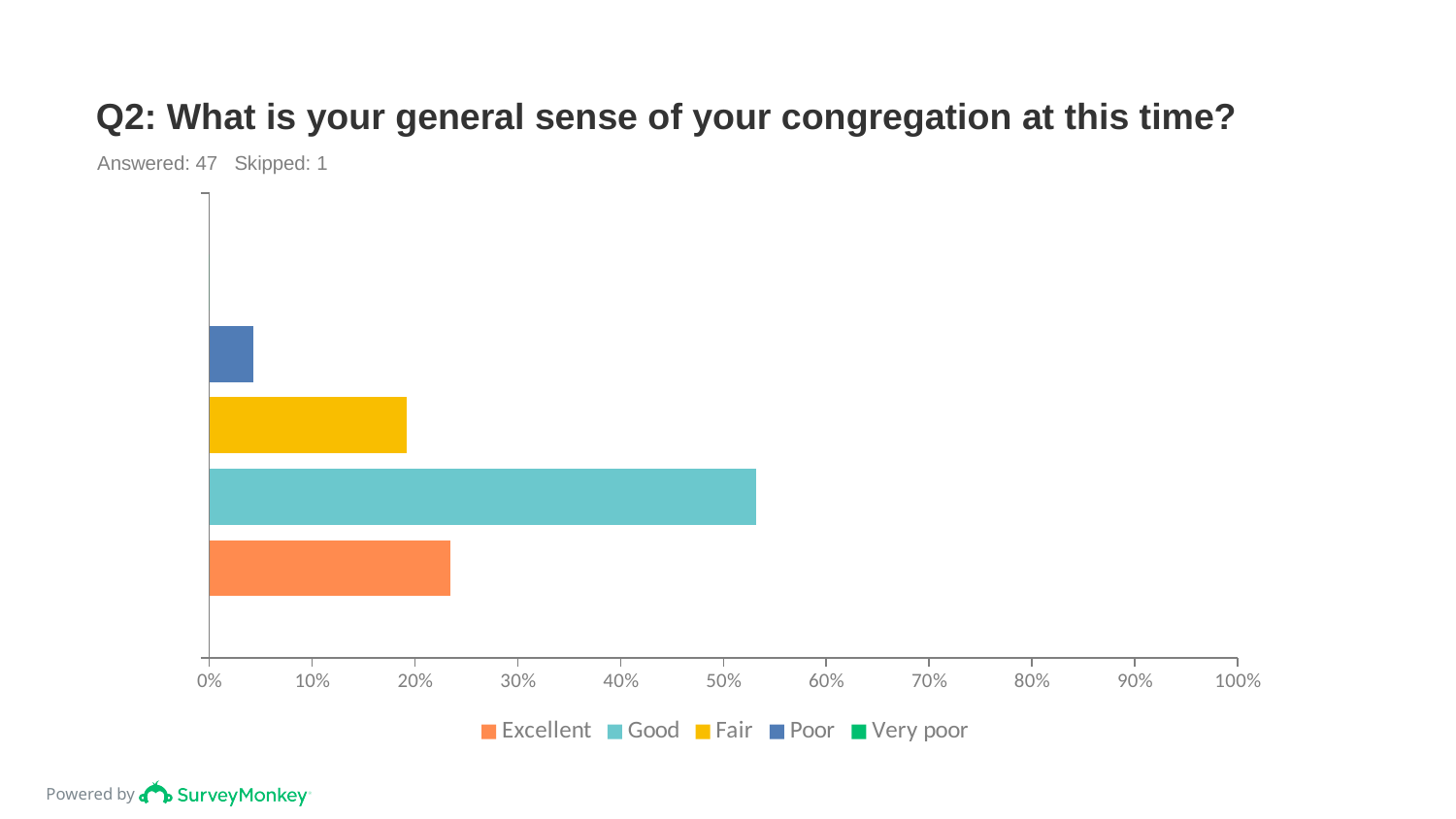
Which category has the highest value? Good How many respondents answered the question according to the slide? 47 What is the title of the chart? Q2: What is your general sense of your congregation at this time? Is the value for Poor greater or less than 10%? less Which category has the shortest visible bar? Poor Is the value for Good greater or less than 50%? greater Is the value for Excellent greater or less than 20%? greater How many entries does the legend list? 5 Which is larger, the value for Good or the value for Excellent? Good What kind of chart is shown on the slide? Bar chart Which is larger, the value for Excellent or the value for Fair? Excellent